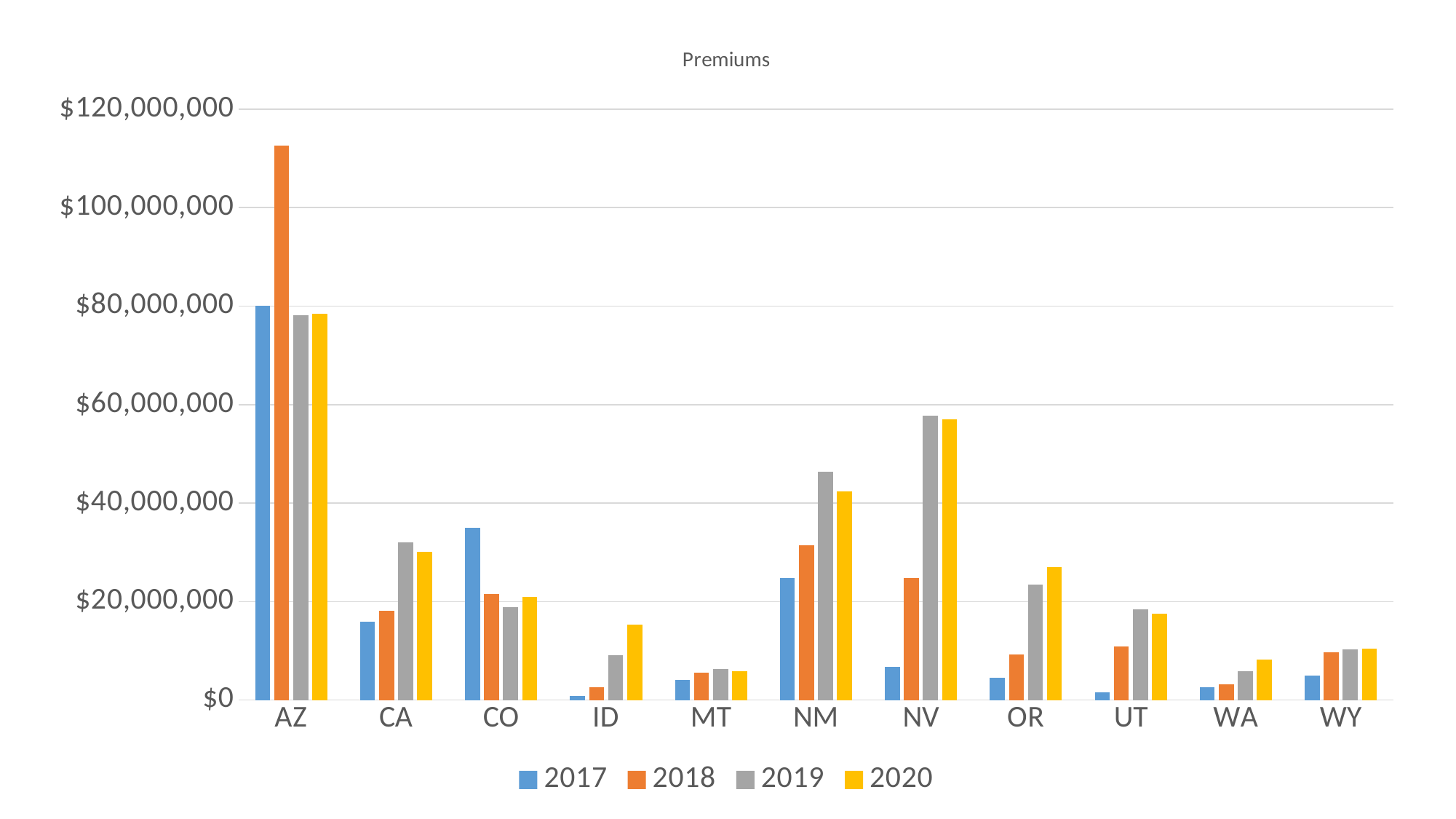
Which is larger, the 2019 value for NM or the 2019 value for NV? NV Is the 2017 value for CO greater or less than $20,000,000? greater For OR, do the values rise or fall from 2017 to 2020? rise How many states are shown along the x axis? 11 What is the title of the chart? Premiums What kind of chart is shown on the slide? bar chart Which state has the highest 2018 value? AZ Which is larger, the 2017 value for CO or the 2017 value for CA? CO Is the 2019 value for NV greater or less than $40,000,000? greater Is the 2018 value for AZ greater or less than $100,000,000? greater How many series does the legend list? 4 Which state has the lowest 2020 value? MT